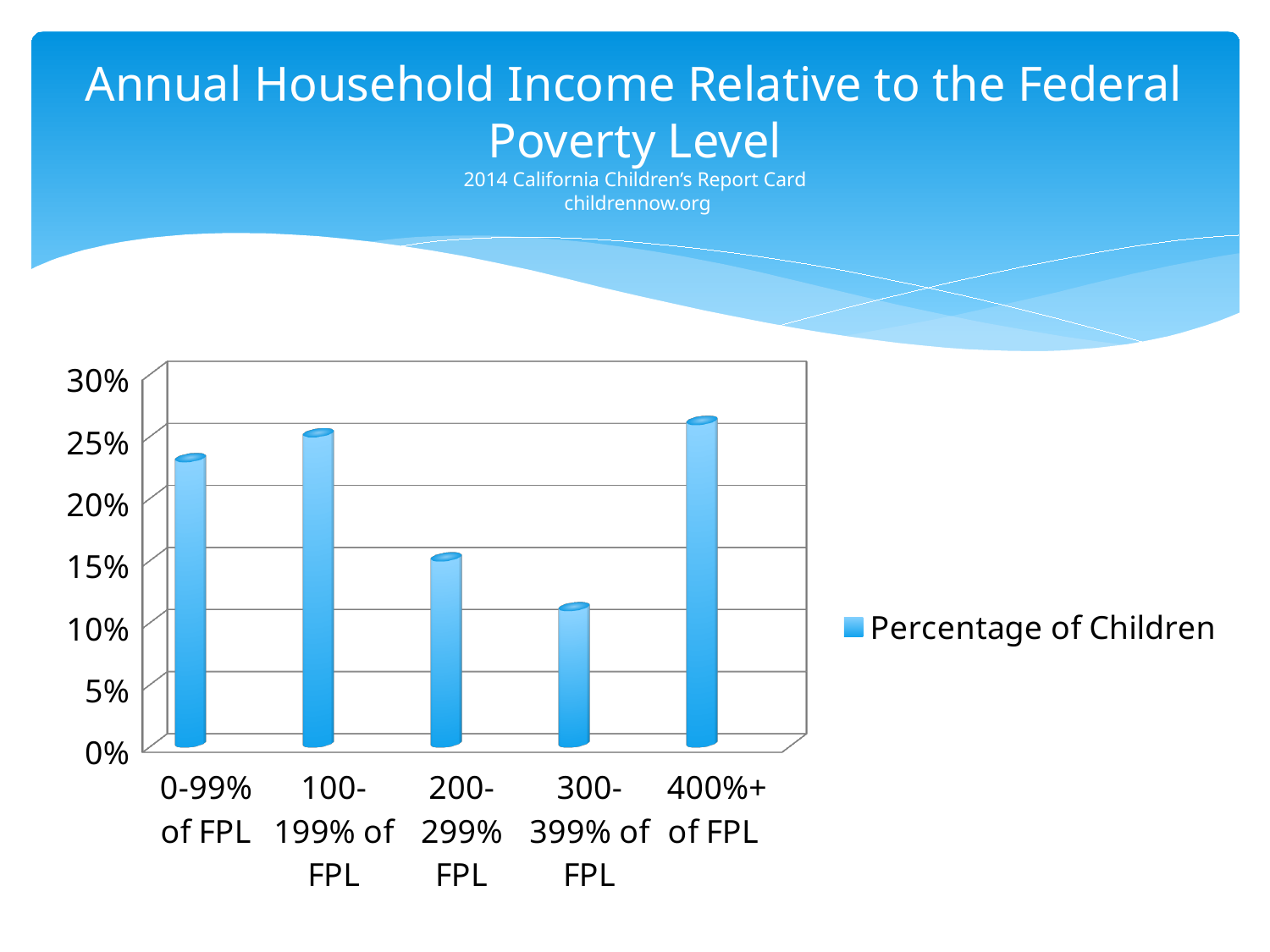
Which is larger, the value for 300-399% of FPL or the value for 100-199% of FPL? 100-199% of FPL Is the value for 0-99% of FPL greater or less than 20%? greater Is the value for 200-299% of FPL greater or less than 20%? less How many series does the legend list? 1 What kind of chart is shown on the slide? bar chart Which is larger, the value for 0-99% of FPL or the value for 200-299% of FPL? 0-99% of FPL Which income category has the lowest percentage of children? 300-399% of FPL What is the name of the series shown in the legend? Percentage of Children Is the value for 300-399% of FPL greater or less than 15%? less How many income categories are shown on the x axis? 5